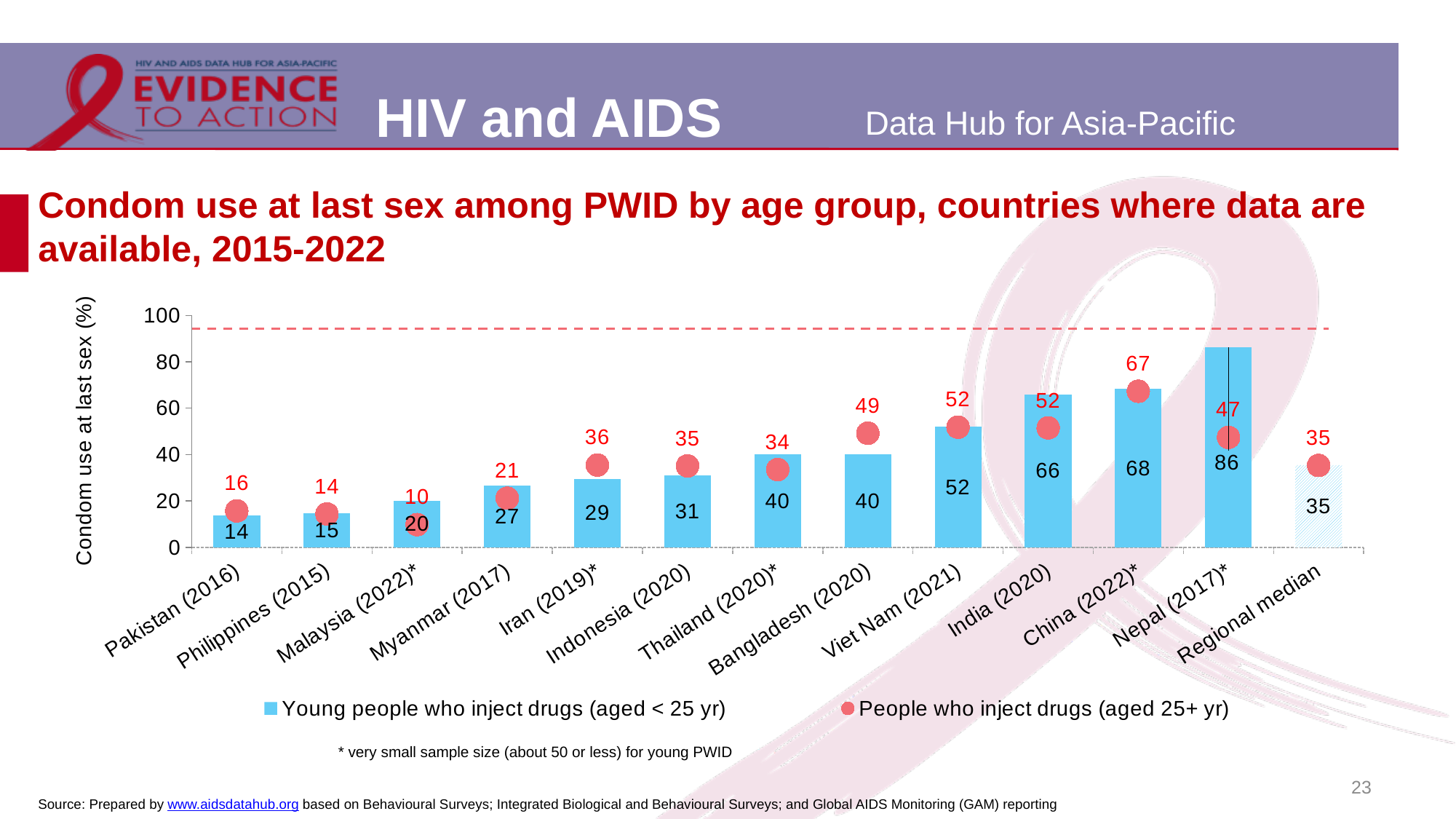
What is the label of the y axis? Condom use at last sex (%) What is the value for people who inject drugs (aged 25+ yr) in Bangladesh (2020)? 49 How many categories are shown on the x axis, including the regional median? 13 What is the difference between the young people (aged < 25 yr) value and the aged 25+ yr value for Nepal (2017)*? 39 For India (2020), which is larger: the value for young people who inject drugs (aged < 25 yr) or the value for people who inject drugs (aged 25+ yr)? Young people who inject drugs (aged < 25 yr) Is the value for young people who inject drugs (aged < 25 yr) in China (2022)* greater or less than 60? greater What is the regional median for young people who inject drugs (aged < 25 yr)? 35 How many series does the legend list? 2 What is the value for young people who inject drugs (aged < 25 yr) in Nepal (2017)*? 86 What type of chart is used to show the values for young people who inject drugs (aged < 25 yr)? Bar chart Which country has the highest value for young people who inject drugs (aged < 25 yr)? Nepal (2017)* Which country has the lowest value for people who inject drugs (aged 25+ yr)? Malaysia (2022)*